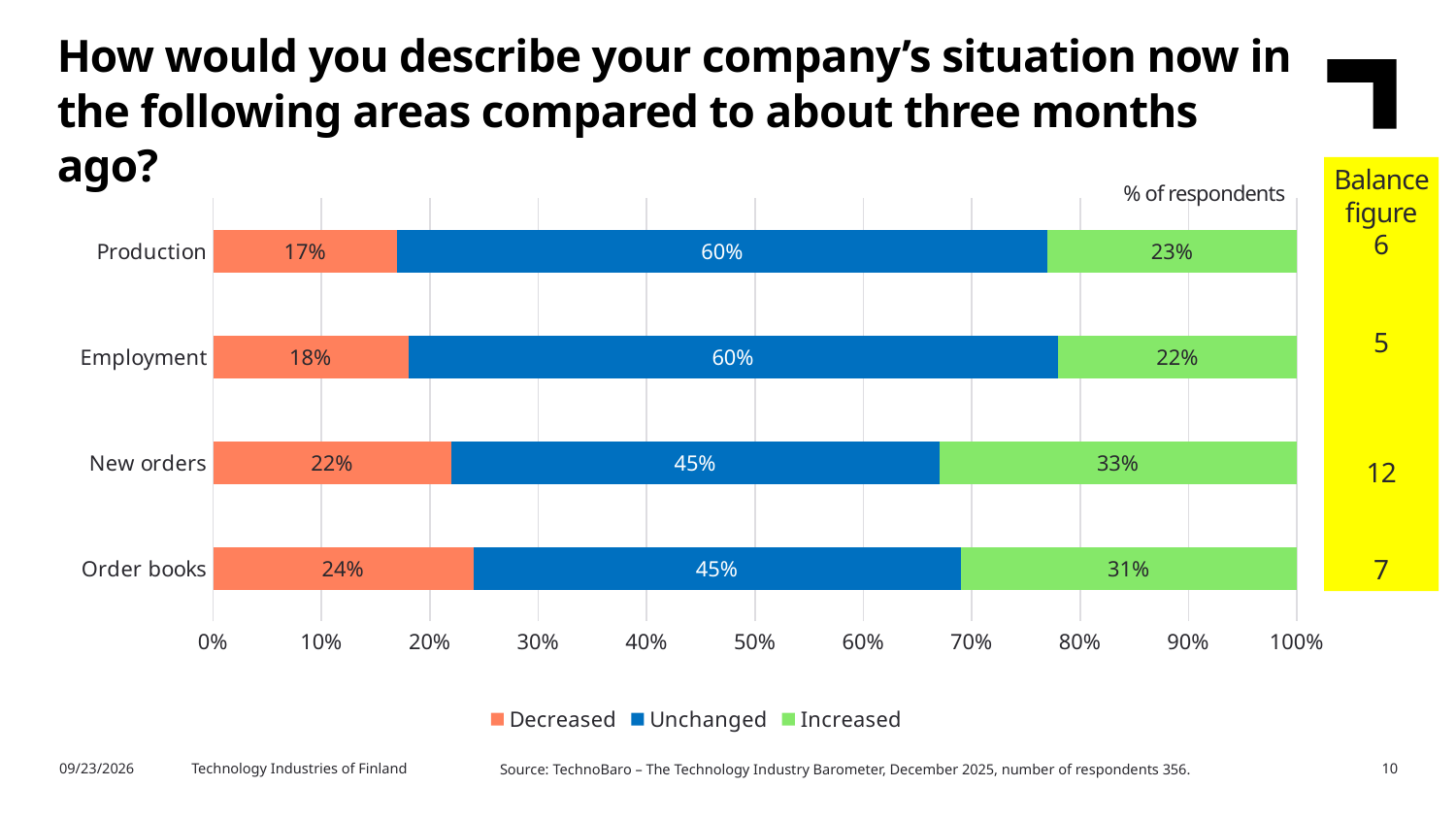
What percentage of respondents reported that New orders increased? 33% How many series does the legend list? 3 How many categories are shown on the chart? 4 Which colour represents 'Unchanged' in the chart? Blue Which category has the lowest share of respondents reporting 'Decreased'? Production What is the difference between the 'Increased' share for New orders and for Employment? 11 percentage points Which category has the highest share of respondents reporting 'Increased'? New orders What kind of chart is shown on the slide? Stacked bar chart What is the balance figure shown for New orders? 12 What percentage of respondents reported that Order books decreased? 24% What percentage of respondents reported that Production was unchanged? 60% Which is larger: the 'Decreased' share for Order books or for Employment? Order books